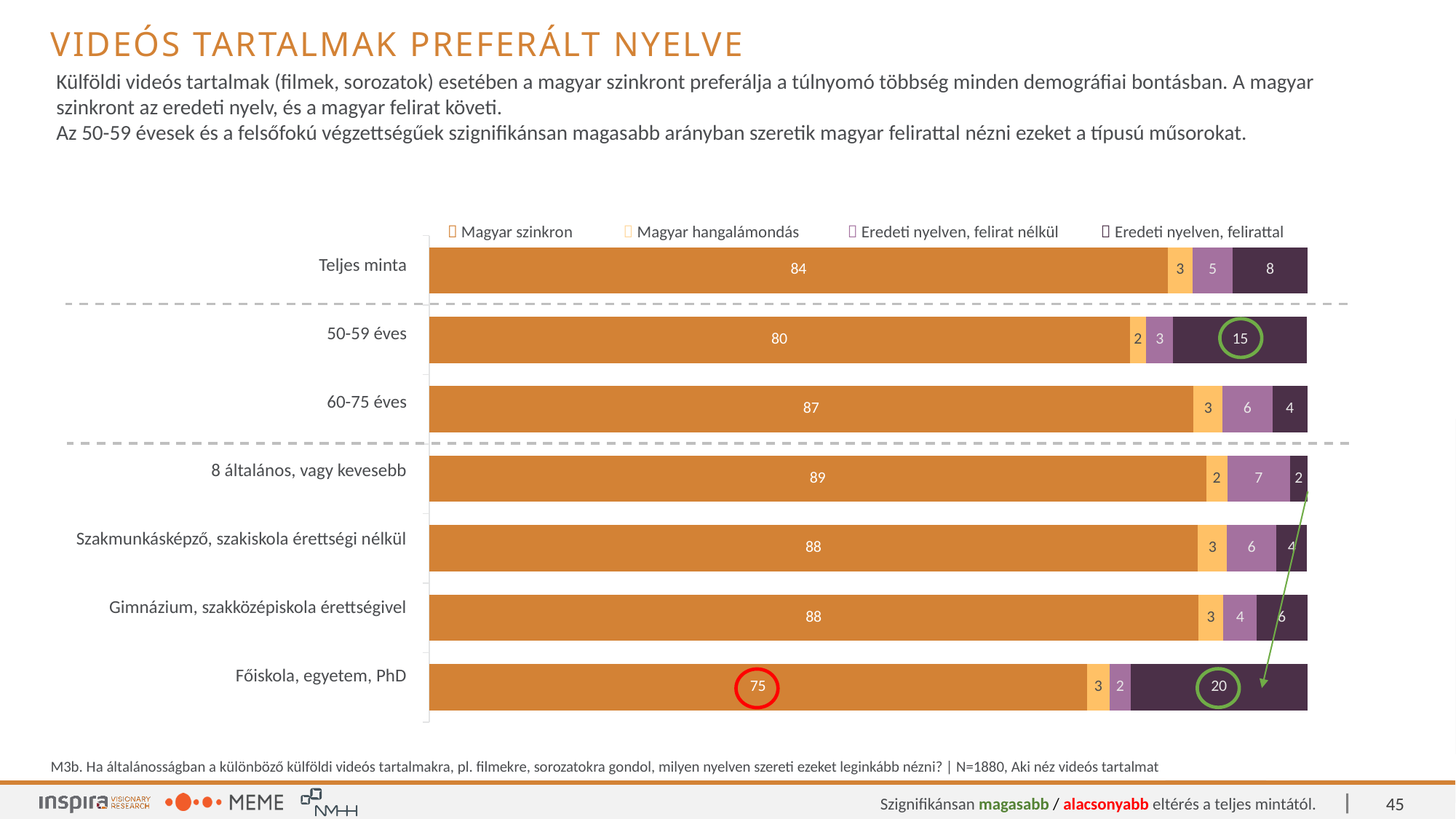
What is the difference between the 'Eredeti nyelven, felirattal' values for 'Főiskola, egyetem, PhD' and '50-59 éves'? 5 What type of chart is shown on the slide? stacked bar chart What is the value of 'Eredeti nyelven, felirattal' for 'Főiskola, egyetem, PhD'? 20 Which category has the highest value for 'Magyar szinkron'? 8 általános, vagy kevesebb Which legend entry is shown in the darkest colour? Eredeti nyelven, felirattal How many series does the legend list? 4 How many categories (bars) are plotted in the chart? 7 Which category has the lowest value for 'Magyar szinkron'? Főiskola, egyetem, PhD Which is larger: the 'Magyar szinkron' value for '60-75 éves' or for '50-59 éves'? 60-75 éves What is the total of the stacked bar for 'Teljes minta'? 100 What is the value of 'Magyar szinkron' for 'Teljes minta'? 84 What is the value of 'Eredeti nyelven, felirat nélkül' for '8 általános, vagy kevesebb'? 7